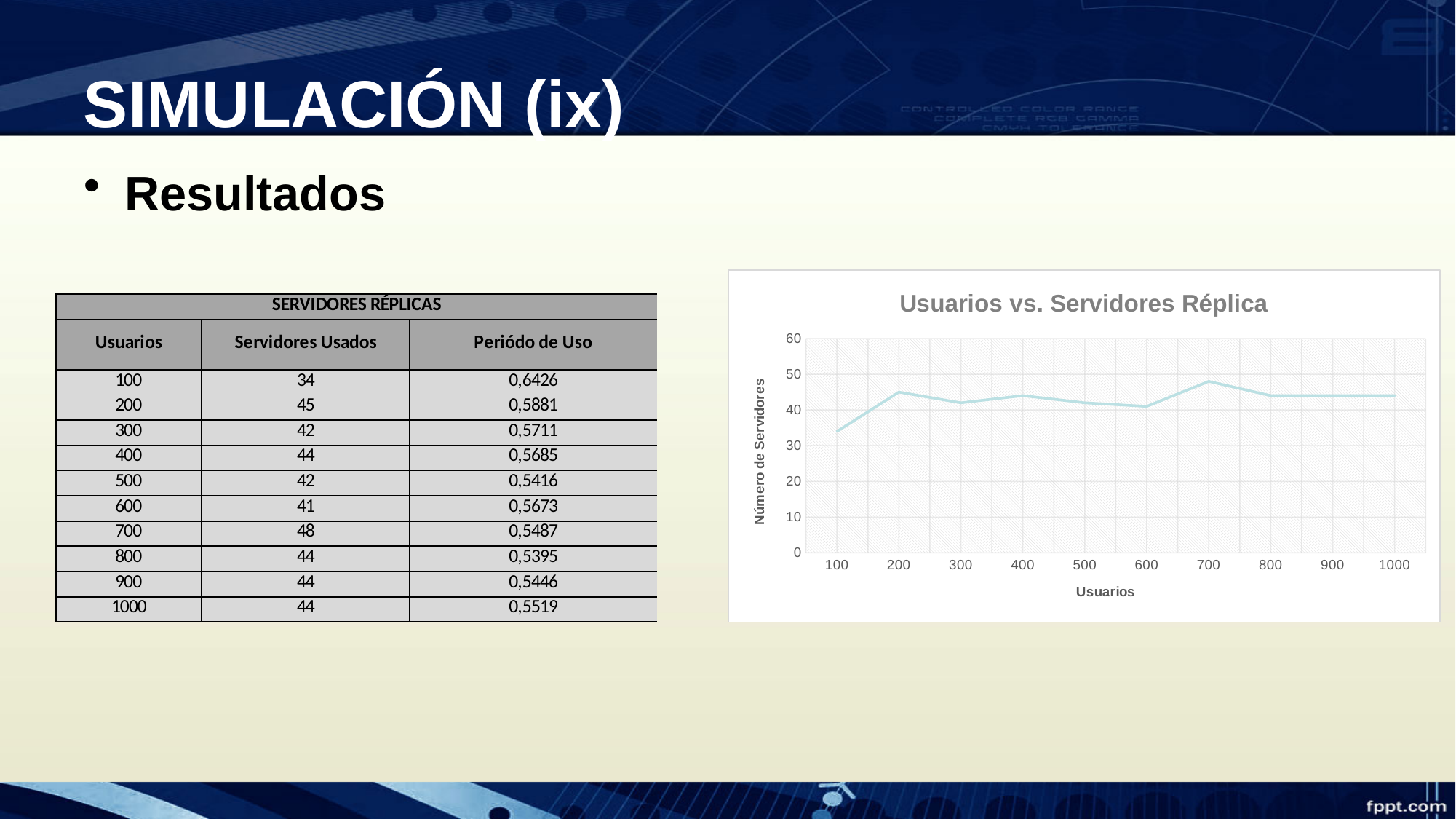
How many servers are used for 700 Usuarios, according to the table on the slide? 48 What is the title of the chart? Usuarios vs. Servidores Réplica What kind of chart is shown on the slide? line chart Is the value for 700 Usuarios greater or less than 40? greater How many data points are plotted on the line in the chart? 10 At which number of Usuarios does the line reach its highest value? 700 Which has a higher number of servers, 600 Usuarios or 700 Usuarios? 700 Usuarios Is the value for 700 Usuarios greater or less than 50? less Is the value for 100 Usuarios greater or less than 40? less What is the label of the vertical axis of the chart? Número de Servidores At which number of Usuarios does the line have its lowest value? 100 Does the line rise or fall between 100 and 200 Usuarios? rise